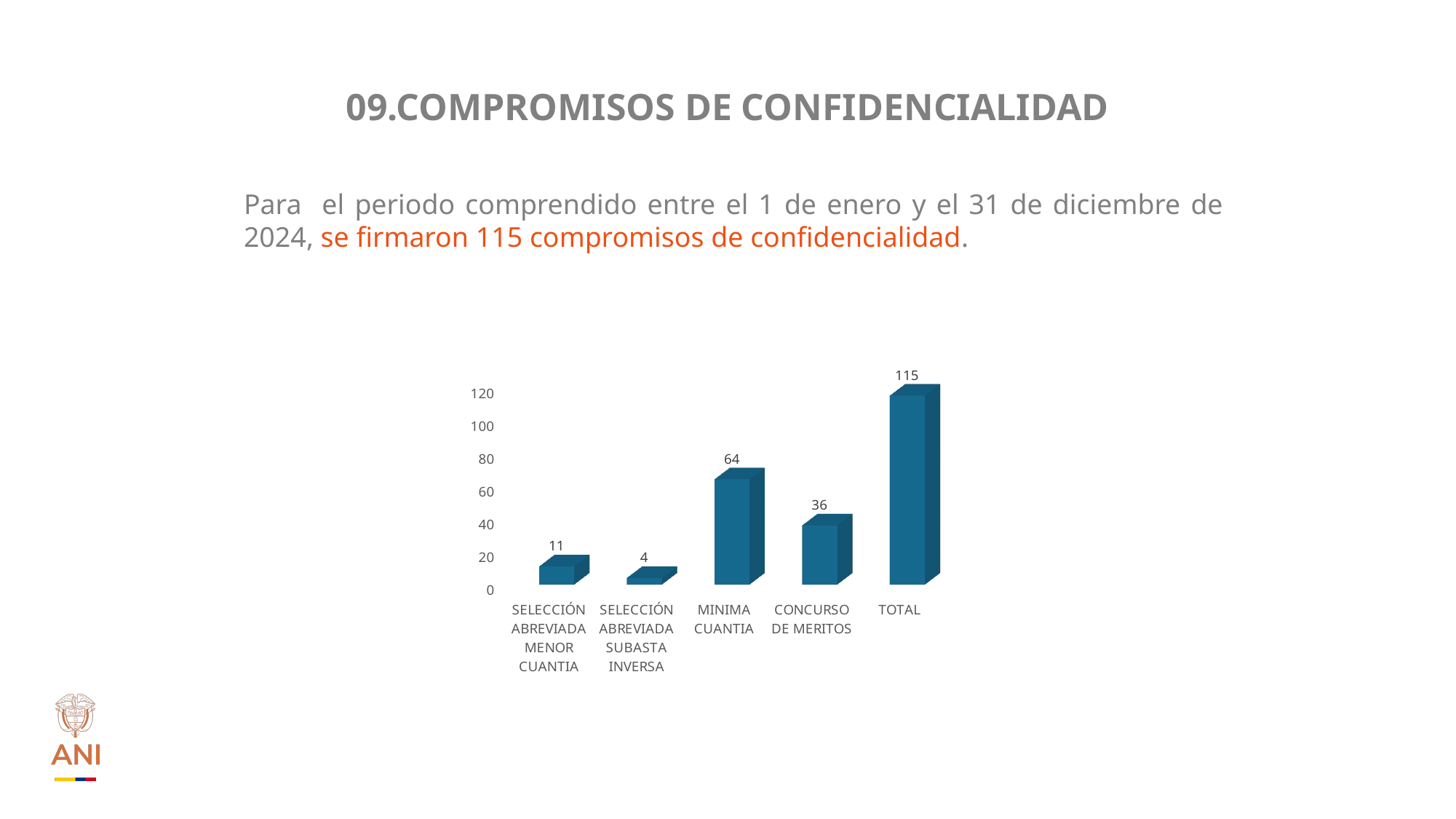
What is the value for CONCURSO DE MERITOS? 36 What kind of chart is shown on the slide? bar chart What is the value for SELECCIÓN ABREVIADA MENOR CUANTIA? 11 What is the highest value shown on the vertical axis? 120 How many bars are shown in the chart? 5 What is the value for MINIMA CUANTIA? 64 What is the value for TOTAL? 115 What is the difference between MINIMA CUANTIA and CONCURSO DE MERITOS? 28 Excluding TOTAL, which category has the highest value? MINIMA CUANTIA Which category has the lowest value? SELECCIÓN ABREVIADA SUBASTA INVERSA Which is larger, SELECCIÓN ABREVIADA MENOR CUANTIA or CONCURSO DE MERITOS? CONCURSO DE MERITOS What is the value for SELECCIÓN ABREVIADA SUBASTA INVERSA? 4